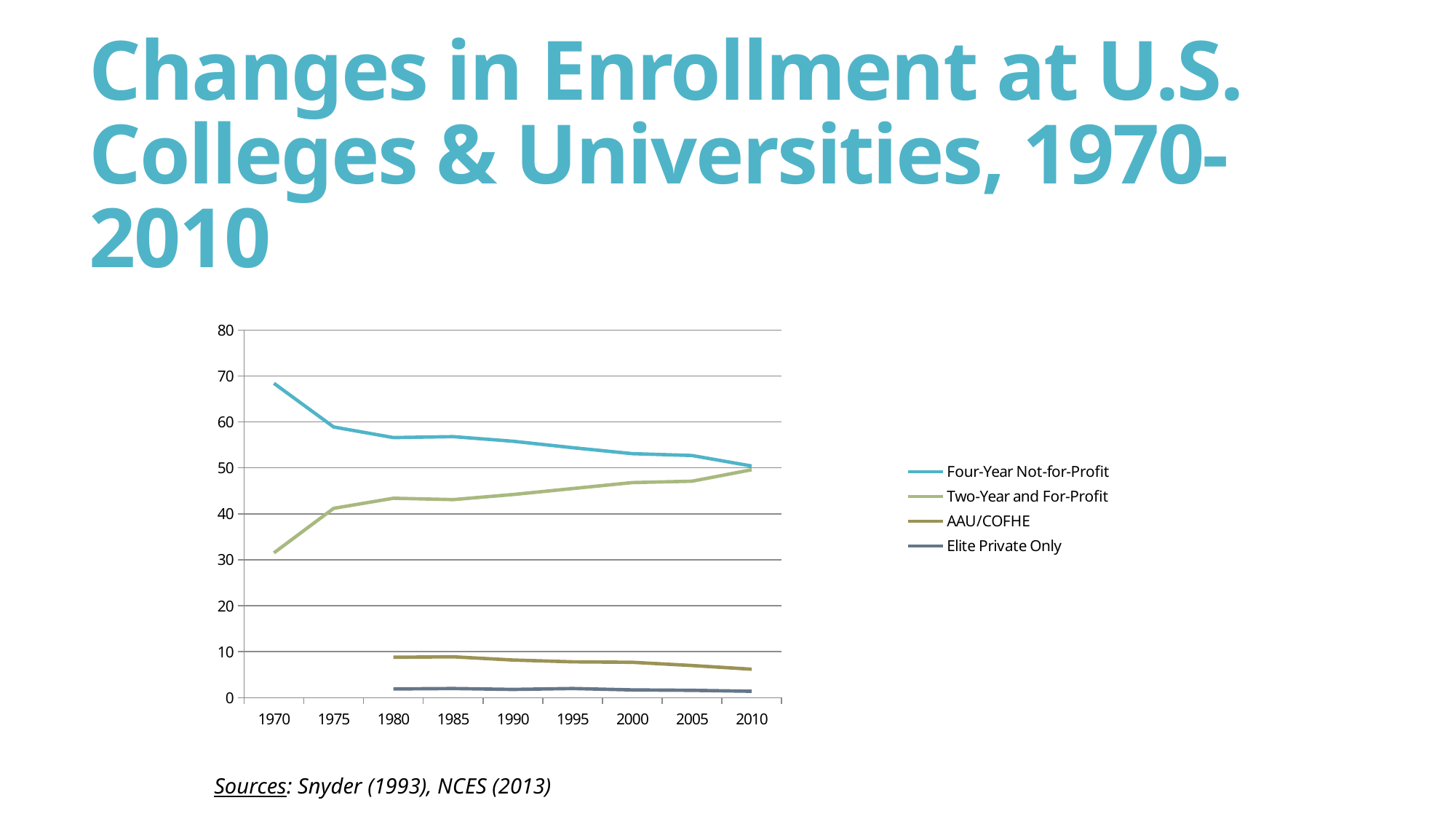
What is the title of the slide containing the chart? Changes in Enrollment at U.S. Colleges & Universities, 1970-2010 In 1970, which is larger: Four-Year Not-for-Profit or Two-Year and For-Profit? Four-Year Not-for-Profit Is the value for Two-Year and For-Profit in 1970 greater or less than 40? less Is the value for AAU/COFHE in 1980 greater or less than 10? less Does the Four-Year Not-for-Profit line rise or fall from 1970 to 2010? Fall Which series has the highest value in 1975? Four-Year Not-for-Profit Does the Two-Year and For-Profit line rise or fall from 1970 to 2010? Rise What kind of chart is shown on the slide? Line chart How many series does the legend list? 4 How many years are labelled along the x axis? 9 Which series has the lowest values across the chart? Elite Private Only Is the value for Four-Year Not-for-Profit in 1970 greater or less than 60? greater